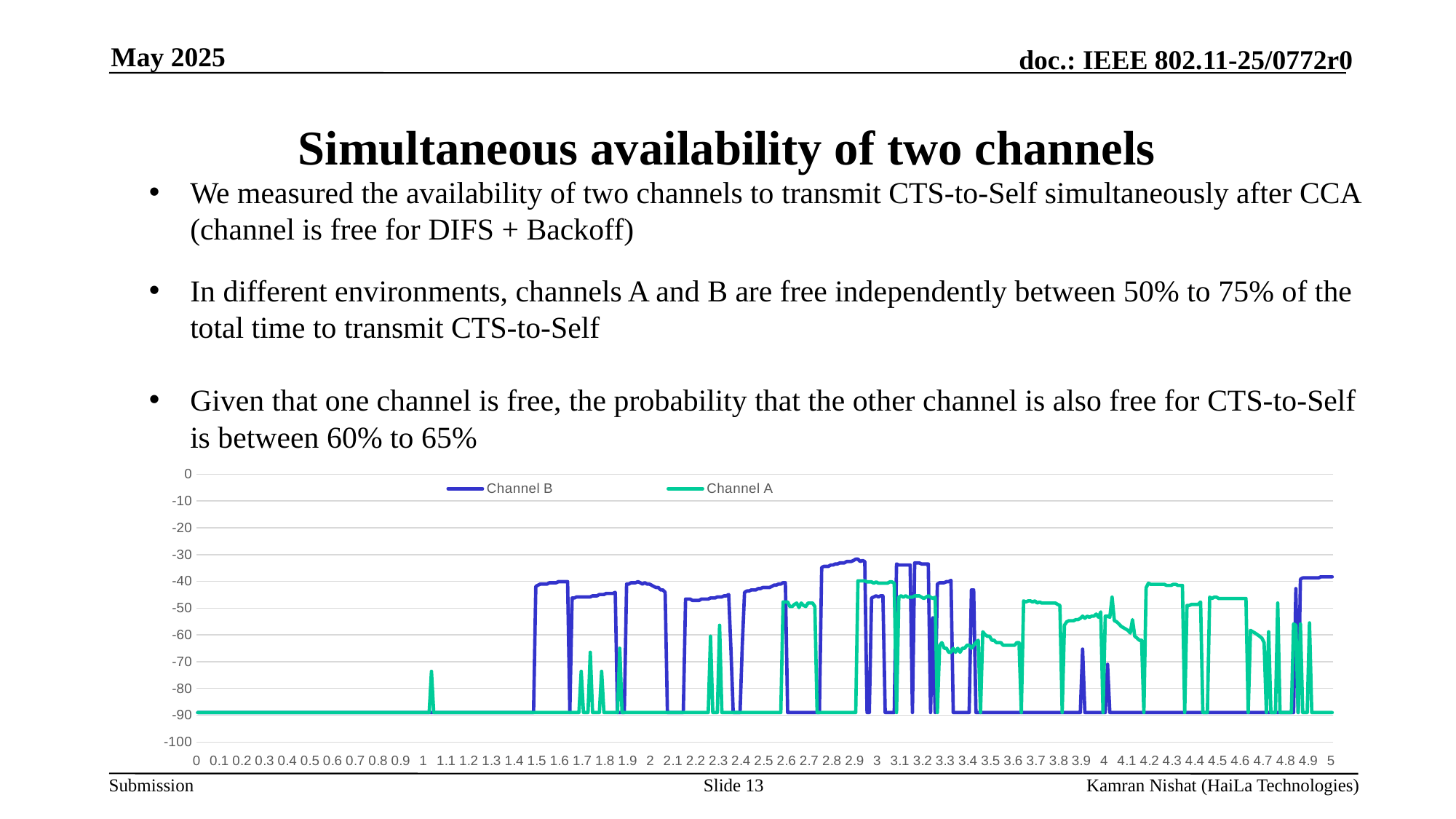
Is the value of Channel B at x = 1 greater or less than -80? less What kind of chart is shown on the slide? line chart At x = 4.3, which series has the higher value, Channel A or Channel B? Channel A What is the lowest value labelled on the chart's vertical axis? -100 Which colour is used for the Channel A line in the chart? green What are the two series named in the chart legend? Channel B and Channel A At x = 1.5, which series has the higher value, Channel A or Channel B? Channel B Is the value of Channel B at x = 1.5 greater or less than -50? greater Is the value of Channel A at x = 0.5 greater or less than -50? less How many series does the chart legend list? 2